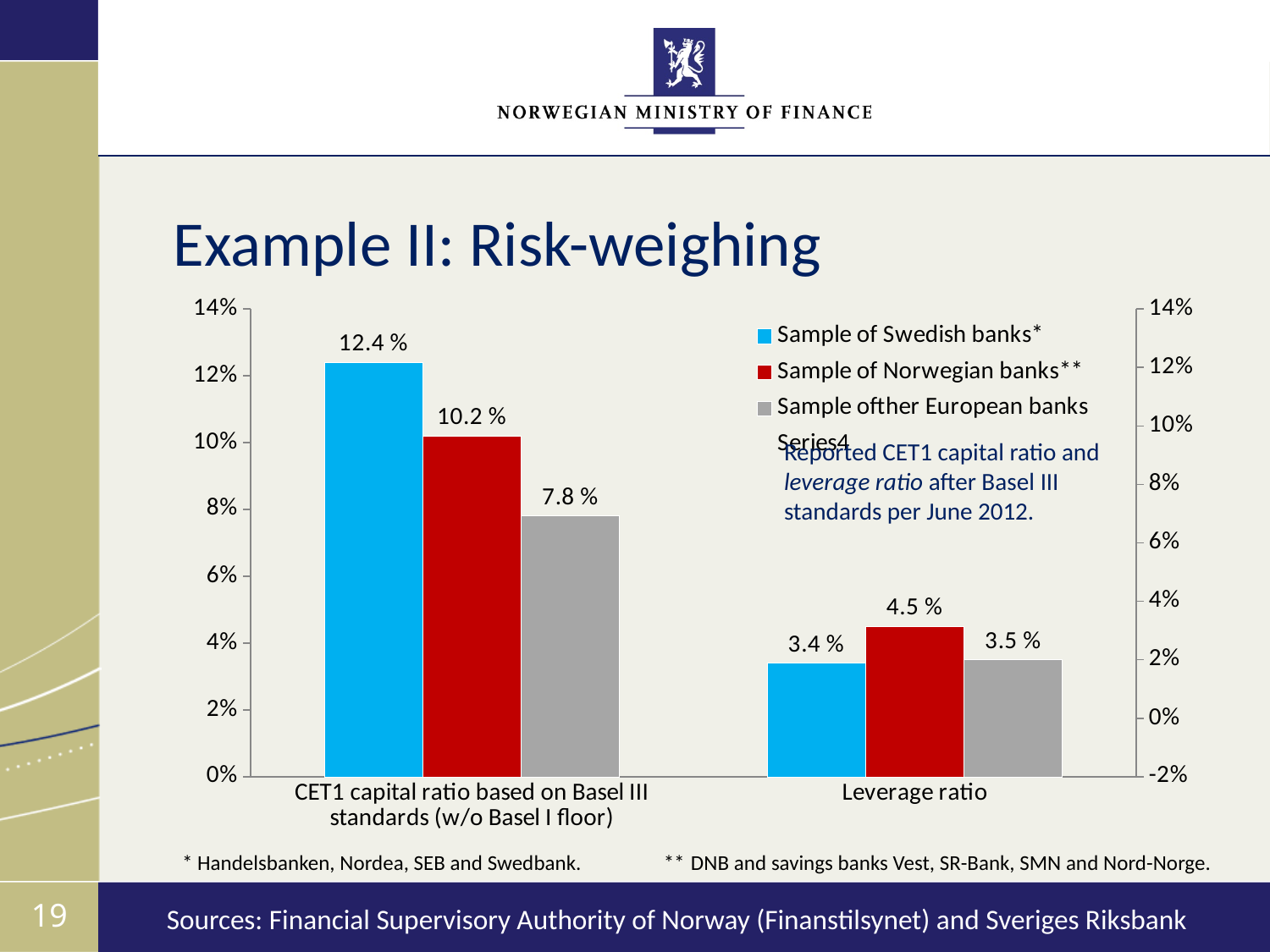
What is the difference between the leverage ratio of the Norwegian banks sample and the Swedish banks sample? 1.1 % What is the CET1 capital ratio for the sample of Swedish banks? 12.4 % How many categories are shown on the x axis? 2 Which is larger: the leverage ratio of the Norwegian banks sample or the other European banks sample? Sample of Norwegian banks What colour are the bars for the sample of Norwegian banks? Red What is the leverage ratio for the sample of other European banks? 3.5 % What is the CET1 capital ratio for the sample of Norwegian banks? 10.2 % What is the difference between the CET1 capital ratio of the Swedish banks sample and the other European banks sample? 4.6 % Which sample has the lowest leverage ratio? Sample of Swedish banks What is the leverage ratio for the sample of Norwegian banks? 4.5 % Which sample has the highest CET1 capital ratio? Sample of Swedish banks What kind of chart is shown on the slide? Bar chart